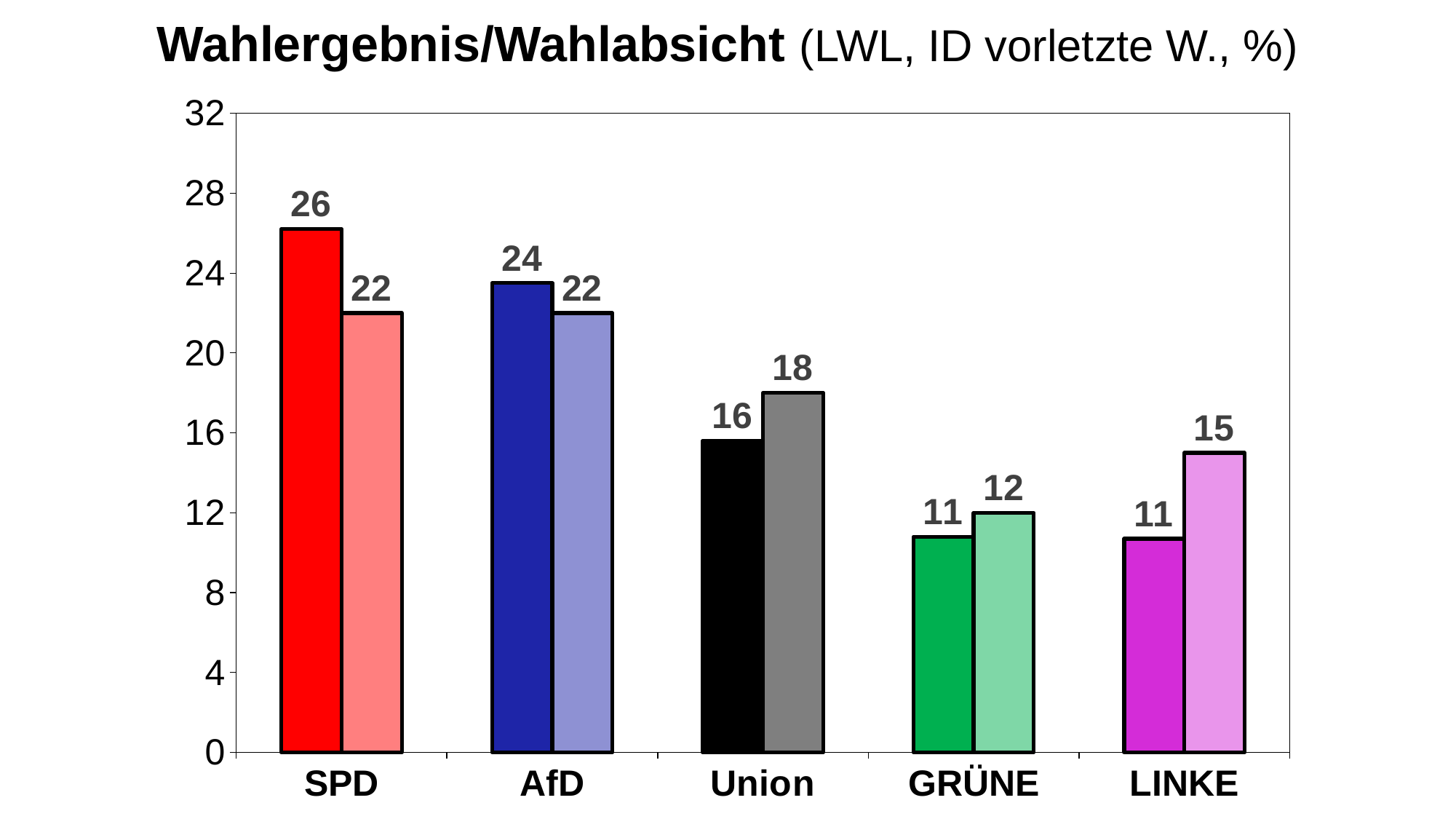
What is the value of the second (lighter) bar for Union? 18 What kind of chart is shown on the slide? bar chart What is the value of the second (lighter) bar for LINKE? 15 How many categories are shown on the x axis? 5 Which category has the lowest value among the second (lighter) bars? GRÜNE What is the bold part of the chart title? Wahlergebnis/Wahlabsicht What is the difference between the two bars for LINKE? 4 What is the difference between the two bars for SPD? 4 What is the value of the first (darker) bar for AfD? 24 For Union, which bar is larger, the first (darker) or the second (lighter)? the second (lighter) Which category has the highest value among the first (darker) bars? SPD What is the value of the first (darker) bar for SPD? 26